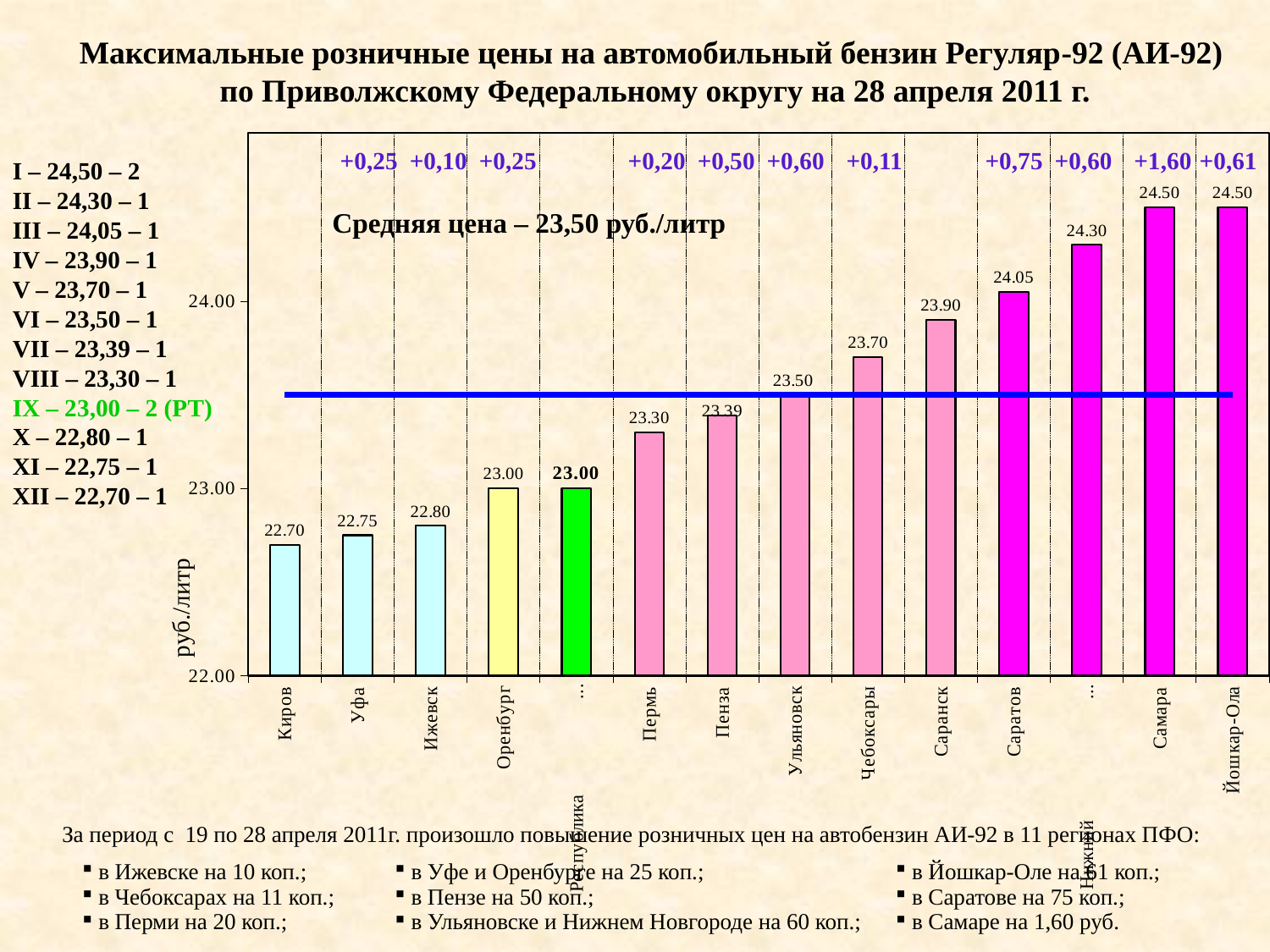
What is the difference between the values for Саратов and Ульяновск? 0.55 Do the values rise or fall from left to right along the x axis? rise What is the value for Саранск? 23.90 Which city has the lowest value? Киров Which is larger, the value for Чебоксары or the value for Пермь? Чебоксары What is the value for Киров? 22.70 What is the difference between the values for Самара and Киров? 1.80 What average price is stated on the chart? 23,50 руб./литр Is the value for Ижевск greater or less than 23.00? less What is the value for Пенза? 23.39 What kind of chart is shown on the slide? bar chart How many bars are shown in the chart? 14